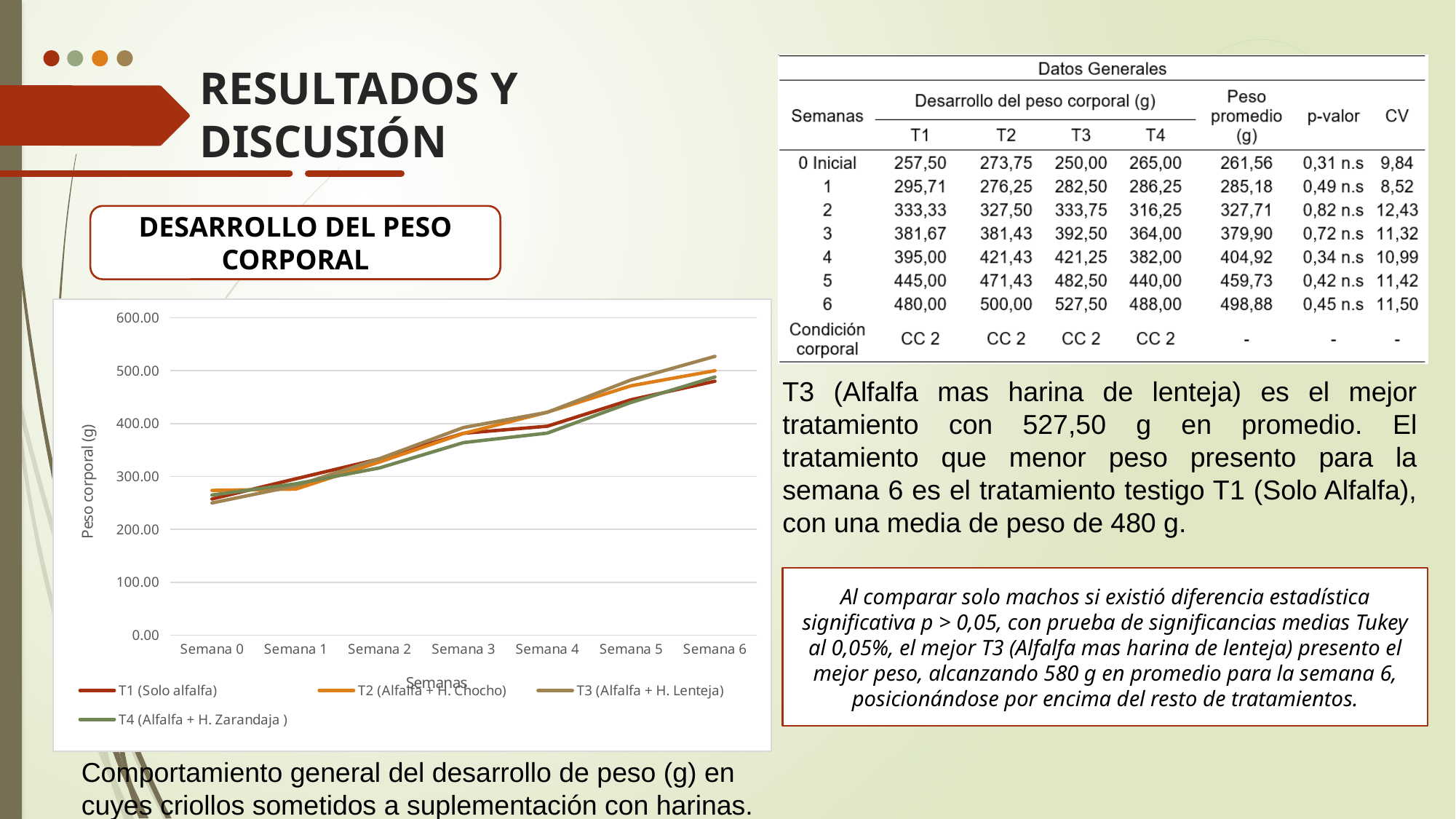
Is the value for T2 (Alfalfa + H. Chocho) at Semana 4 greater or less than 400? greater What kind of chart is shown on the slide? line chart How many series does the chart's legend list? 4 According to the table on the slide, what is the body weight of T3 at week 6? 527,50 What is the title of the chart's y axis? Peso corporal (g) Which treatment has the highest body weight at Semana 6? T3 (Alfalfa + H. Lenteja) At Semana 6, which is larger: the value for T3 (Alfalfa + H. Lenteja) or T1 (Solo alfalfa)? T3 (Alfalfa + H. Lenteja) Is the value for T3 (Alfalfa + H. Lenteja) at Semana 6 greater or less than 500? greater How many weeks (categories) are plotted along the x axis of the chart? 7 According to the table on the slide, what is the body weight of T1 at week 6? 480,00 Do the body weight values rise or fall from Semana 0 to Semana 6? rise Is the value for T1 (Solo alfalfa) at Semana 0 greater or less than 300? less